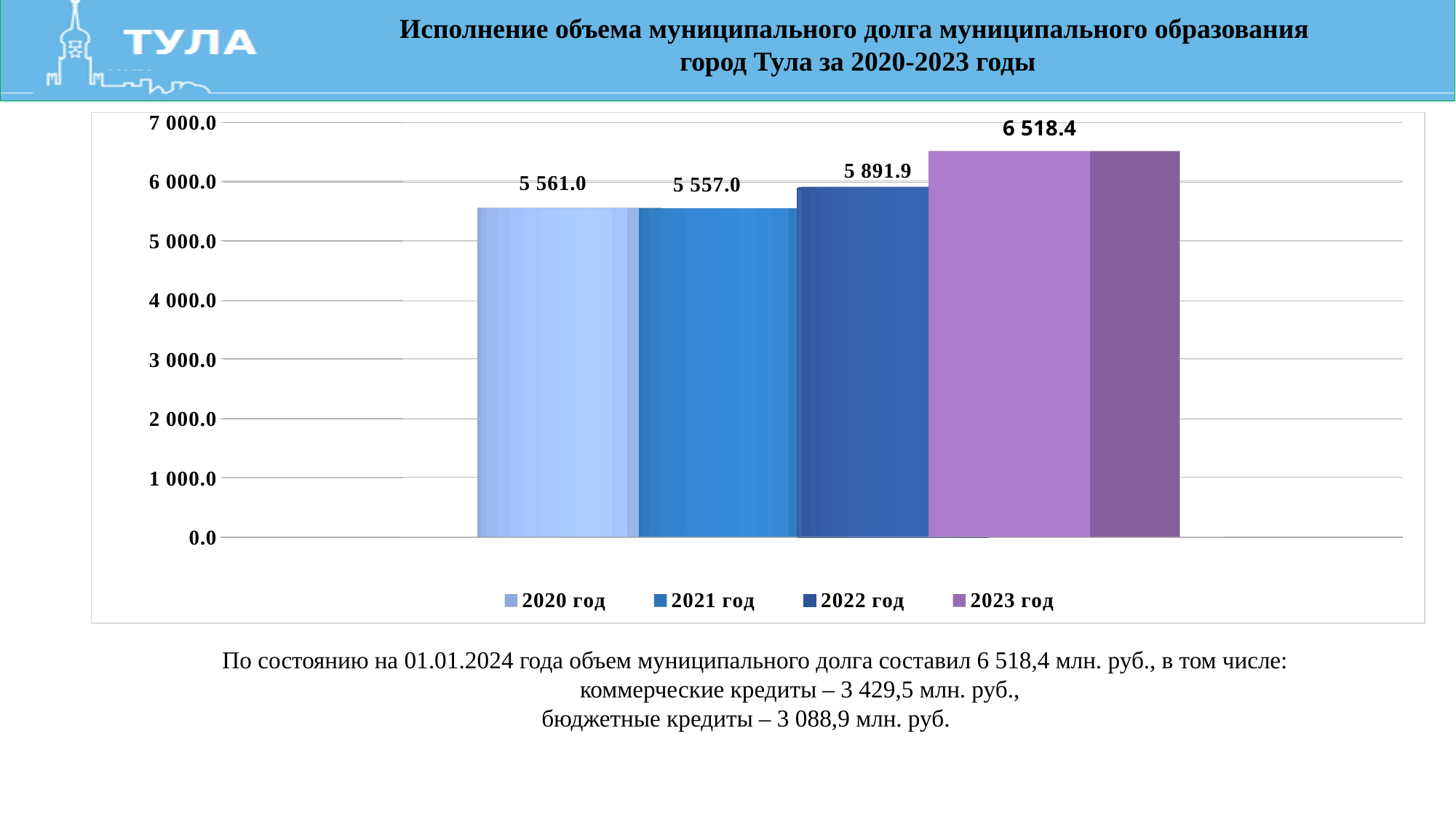
What is the value shown for 2023 год? 6 518.4 Which year has the highest value on the chart? 2023 год What kind of chart is shown on the slide? bar chart What is the difference between the values for 2022 год and 2021 год? 334.9 Is the value for 2023 год greater or less than 6 000.0? greater What is the value shown for 2021 год? 5 557.0 Which is larger, the value for 2022 год or the value for 2021 год? 2022 год What is the difference between the values for 2023 год and 2022 год? 626.5 How many series does the legend list? 4 Which year has the lowest value on the chart? 2021 год What is the value shown for 2022 год? 5 891.9 What is the value shown for 2020 год? 5 561.0